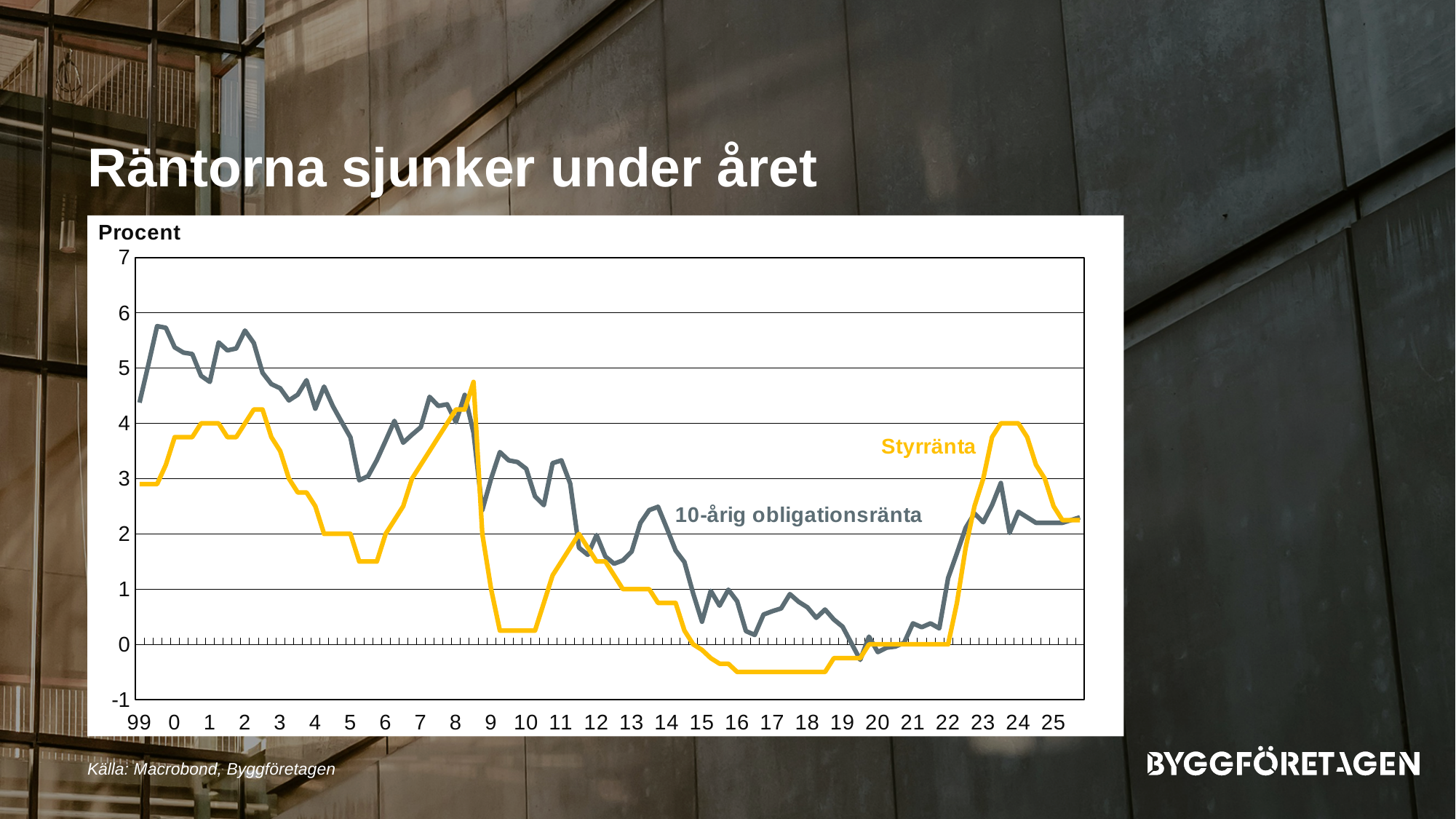
Is the value of the 10-årig obligationsränta at the start of the series (99) greater or less than 4? greater Which series reaches the highest value anywhere on the chart? 10-årig obligationsränta Which series is drawn in yellow? Styrränta What kind of chart is shown on the slide? line chart Does Styrränta rise or fall between 2022 and 2024? rise Is the peak value of Styrränta around 2024 greater or less than 3? greater Does Styrränta rise or fall between 2024 and 2025? fall How many series are plotted on the chart? 2 What is the title of the slide? Räntorna sjunker under året Is the value of Styrränta in 2017 greater or less than 0? less In 2024, which is higher: Styrränta or 10-årig obligationsränta? Styrränta